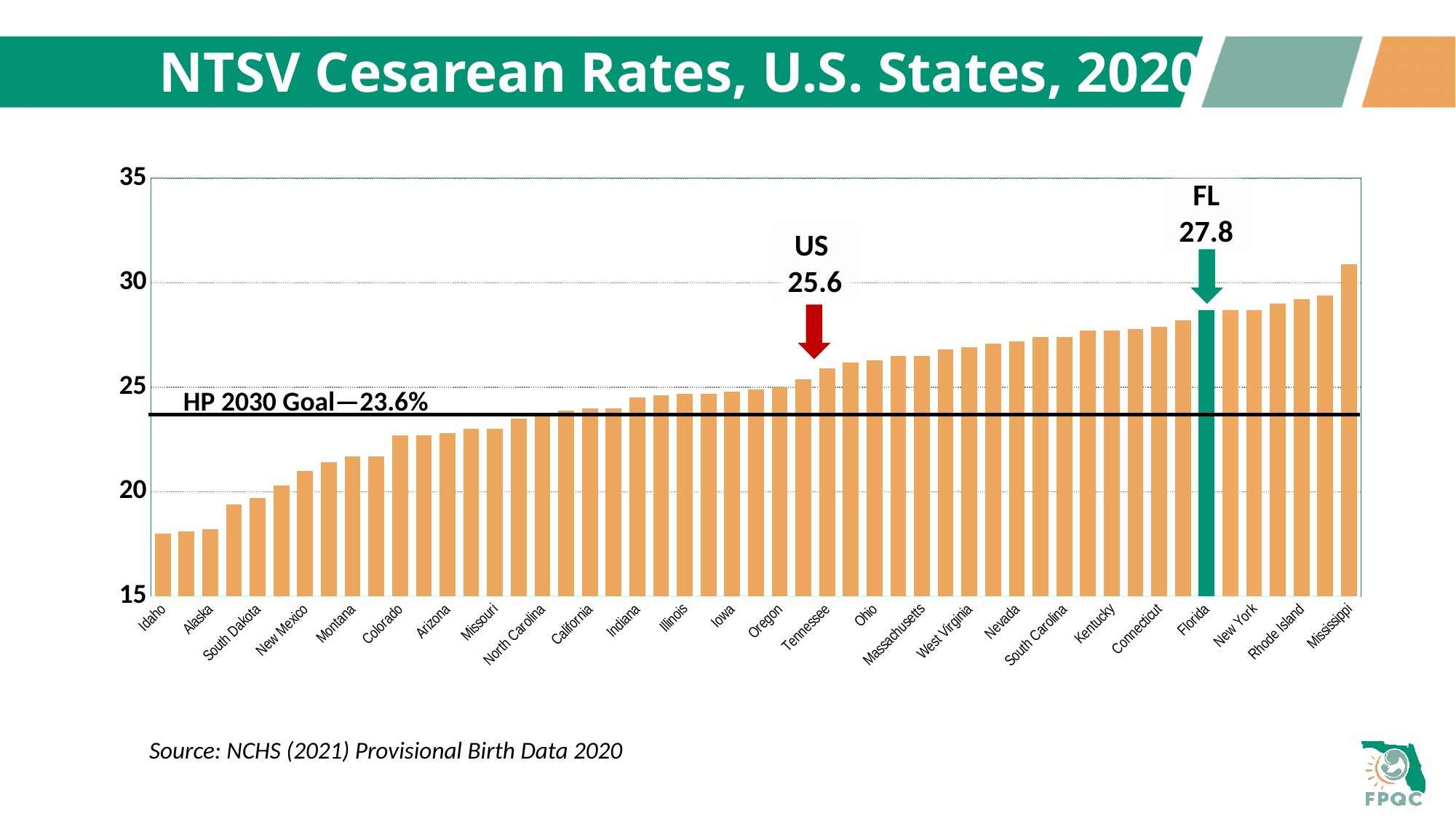
Which has the larger NTSV cesarean rate, Florida or Colorado? Florida What kind of chart is shown on the slide? Bar chart What is the NTSV cesarean rate shown for Florida (FL)? 27.8 Is the value for Mississippi greater or less than 30? greater Which state has the lowest NTSV cesarean rate on the chart? Idaho Do the bar values rise or fall moving from left to right along the x axis? Rise Is the value for Idaho greater or less than 20? less What colour is the bar for Florida? Green What is the HP 2030 Goal value shown by the horizontal line? 23.6% Which state has the highest NTSV cesarean rate on the chart? Mississippi How much higher is Florida's rate (27.8) than the U.S. rate (25.6)? 2.2 What is the U.S. NTSV cesarean rate annotated on the chart? 25.6